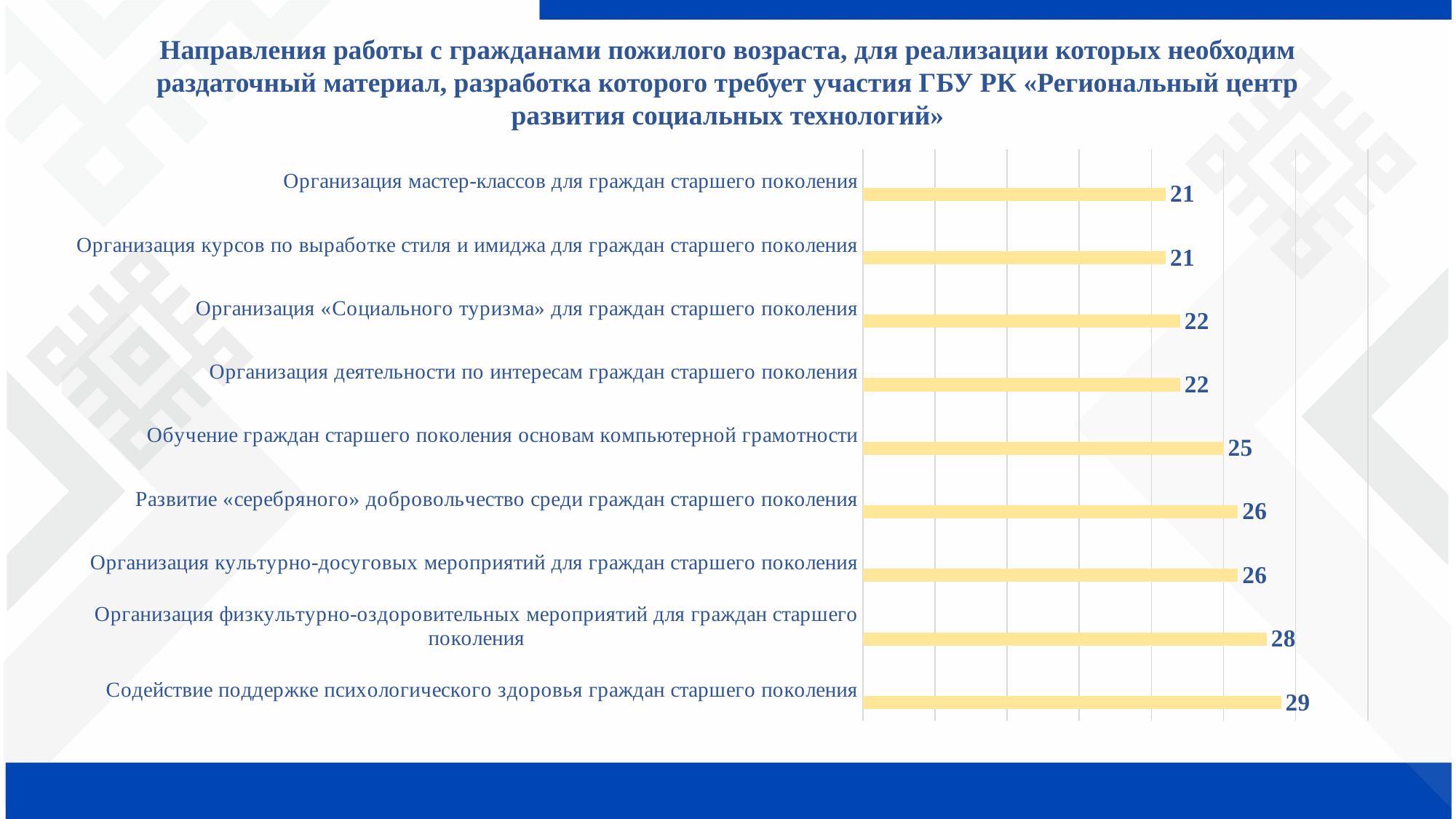
What colour are the bars in the chart? Yellow What is the value for «Обучение граждан старшего поколения основам компьютерной грамотности»? 25 What is the value for «Организация физкультурно-оздоровительных мероприятий для граждан старшего поколения»? 28 What is the difference between the value for «Содействие поддержке психологического здоровья граждан старшего поколения» and the value for «Организация мастер-классов для граждан старшего поколения»? 8 What type of chart is shown on the slide? Bar chart Which category has the highest value? Содействие поддержке психологического здоровья граждан старшего поколения Which is larger: the value for «Обучение граждан старшего поколения основам компьютерной грамотности» or the value for «Организация «Социального туризма» для граждан старшего поколения»? Обучение граждан старшего поколения основам компьютерной грамотности What is the value for «Содействие поддержке психологического здоровья граждан старшего поколения»? 29 What is the difference between the value for «Организация физкультурно-оздоровительных мероприятий для граждан старшего поколения» and the value for «Обучение граждан старшего поколения основам компьютерной грамотности»? 3 How many categories are plotted in the chart? 9 What is the value for «Организация мастер-классов для граждан старшего поколения»? 21 What is the value for «Развитие «серебряного» добровольчество среди граждан старшего поколения»? 26